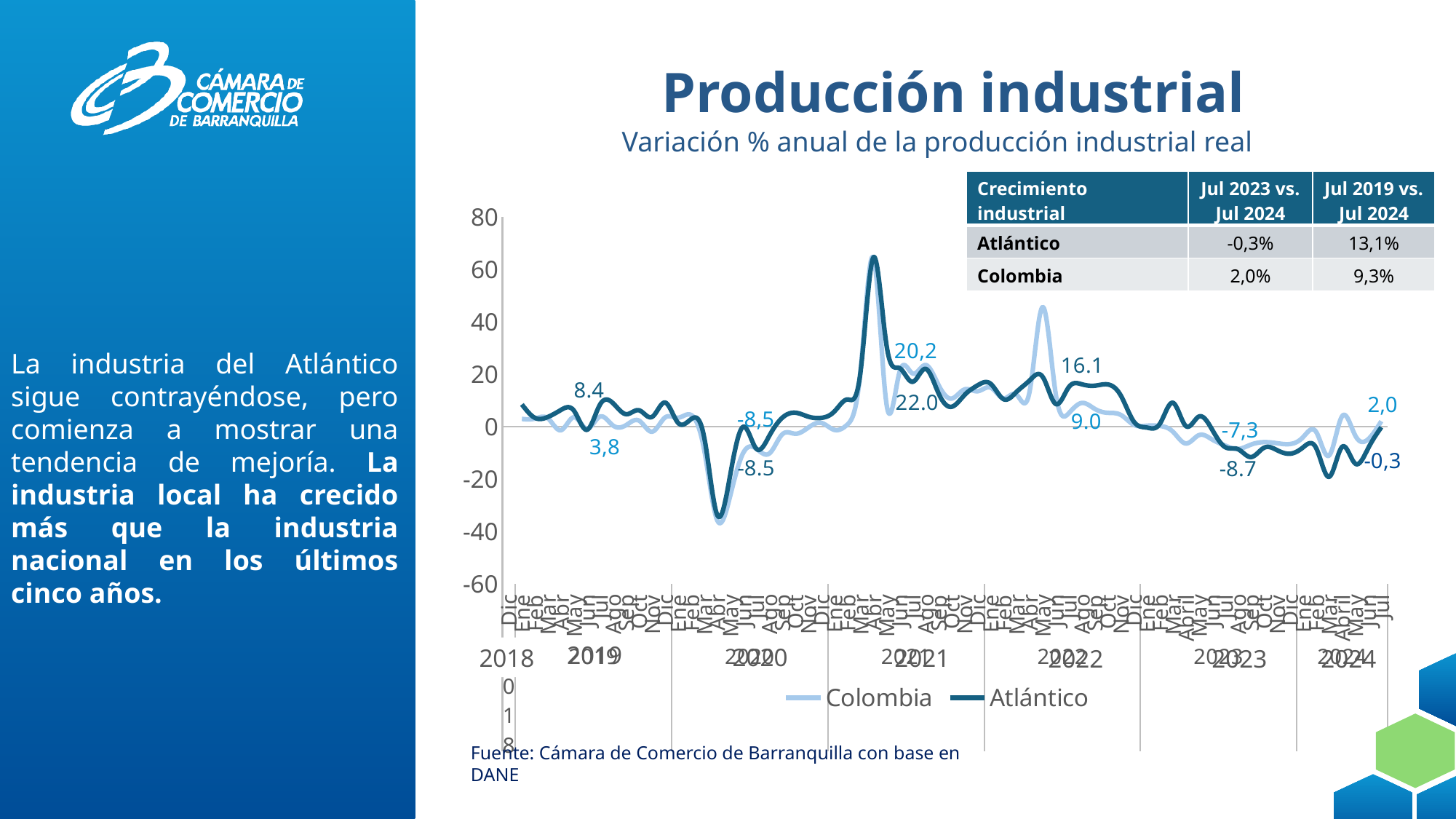
Which series has the larger labelled value in 2022, Colombia (9.0) or Atlántico (16.1)? Atlántico What is the labelled value for Atlántico in 2021? 22.0 How many series does the chart legend list? 2 What is the labelled value for Atlántico in 2019? 8.4 What is the labelled value for Colombia in 2019? 3,8 What is the subtitle of the chart? Variación % anual de la producción industrial real What is the labelled value for Colombia in 2022? 9.0 Is the peak value of the Atlántico line in 2021 greater or less than 60? greater What kind of chart is shown on the slide? line chart What is the labelled value for Atlántico in 2023? -8.7 Which two series are listed in the chart legend? Colombia and Atlántico What is the labelled value for Colombia in 2024? 2,0